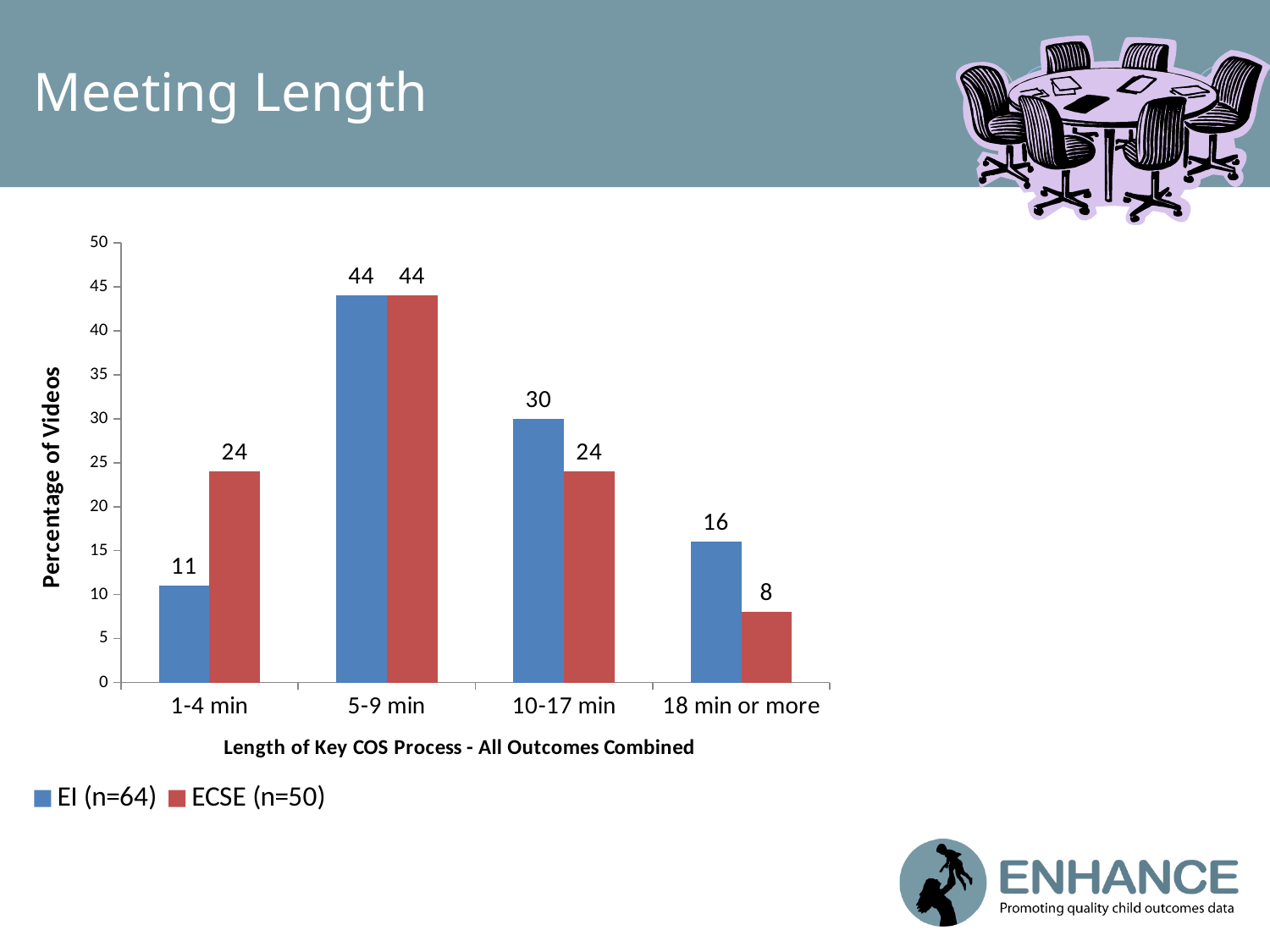
What is the label of the y axis? Percentage of Videos Which series has the larger value in the 10-17 min category, EI (n=64) or ECSE (n=50)? EI (n=64) What kind of chart is shown on the slide? Bar chart Which category has the lowest value for ECSE (n=50)? 18 min or more How many categories are shown on the x axis? 4 What is the value for EI (n=64) in the 1-4 min category? 11 What is the value for ECSE (n=50) in the 10-17 min category? 24 How many series does the legend list? 2 What is the difference between the EI (n=64) and ECSE (n=50) values in the 1-4 min category? 13 What is the label of the x axis? Length of Key COS Process - All Outcomes Combined What is the value for ECSE (n=50) in the 18 min or more category? 8 Which category has the highest value for EI (n=64)? 5-9 min